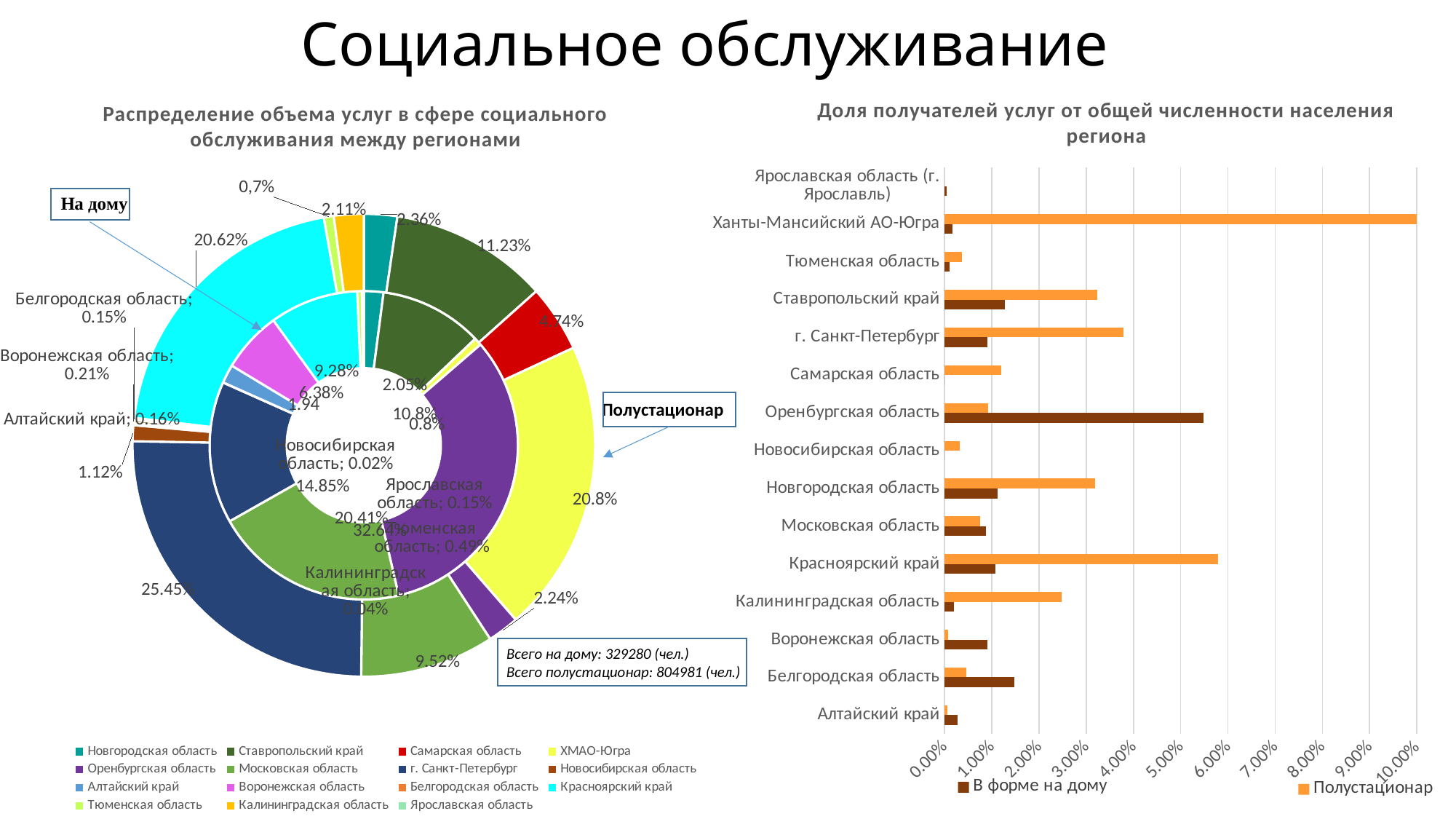
On the right chart 'Доля получателей услуг от общей численности населения региона', which region has the highest 'Полустационар' value? Ханты-Мансийский АО-Югра On the left chart 'Распределение объема услуг в сфере социального обслуживания между регионами', what is the total number of people served 'на дому' according to the text box? 329280 (чел.) On the right chart 'Доля получателей услуг от общей численности населения региона', for Оренбургская область, which is larger: 'В форме на дому' or 'Полустационар'? В форме на дому On the right chart 'Доля получателей услуг от общей численности населения региона', is the 'Полустационар' value for Красноярский край greater or less than 5.00%? greater What kind of chart is the chart on the right, 'Доля получателей услуг от общей численности населения региона'? bar chart On the left chart 'Распределение объема услуг в сфере социального обслуживания между регионами', what is the 'Полустационар' share for ХМАО-Югра? 20.8% On the left chart 'Распределение объема услуг в сфере социального обслуживания между регионами', what is the 'Полустационар' share for г. Санкт-Петербург? 25.45% How many regions are shown on the right chart 'Доля получателей услуг от общей численности населения региона'? 15 How many regions does the legend of the left chart 'Распределение объема услуг в сфере социального обслуживания между регионами' list? 15 On the right chart 'Доля получателей услуг от общей численности населения региона', is the 'Полустационар' value for Калининградская область greater or less than 2.00%? greater On the right chart 'Доля получателей услуг от общей численности населения региона', which region has the highest 'В форме на дому' value? Оренбургская область How many series does the legend of the right chart 'Доля получателей услуг от общей численности населения региона' list? 2